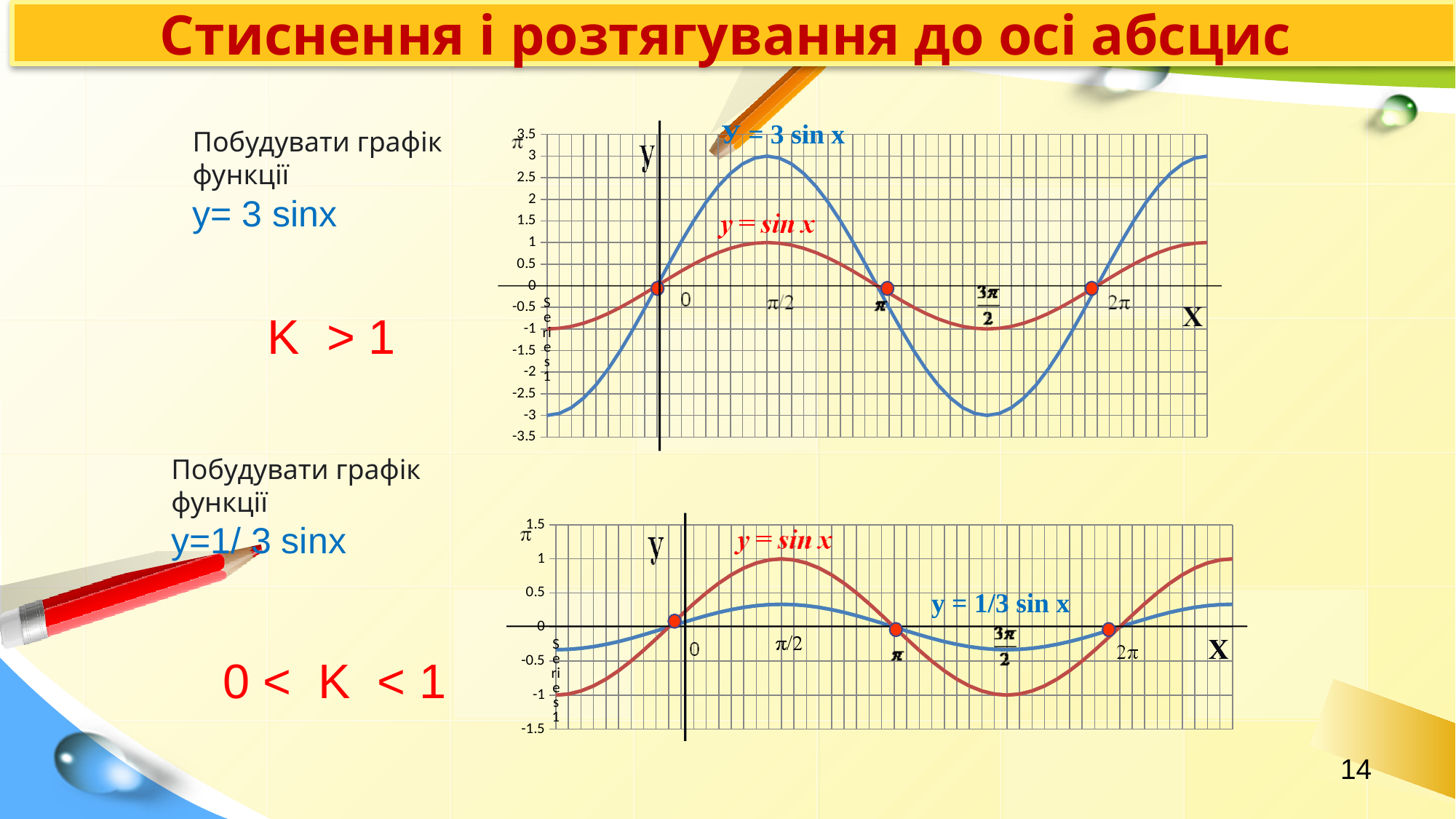
On the top chart, what is the maximum value reached by the curve y = 3 sin x? 3 On the bottom chart, what is the maximum value reached by the curve y = sin x? 1 On the bottom chart, is the peak value of y = 1/3 sin x greater or less than 0.5? less On the top chart, what is the difference between the peak of y = 3 sin x and the peak of y = sin x? 2 On the top chart, what is the minimum value reached by the curve y = 3 sin x? -3 On the bottom chart, what is the highest value labelled on the vertical axis? 1.5 On the bottom chart, what colour is the curve y = 1/3 sin x? blue What type of chart is the top chart on the slide? line chart On the top chart, does the curve y = 3 sin x rise or fall between x = π/2 and x = 3π/2? fall On the top chart, which curve is higher at x = π/2, y = 3 sin x or y = sin x? y = 3 sin x On the top chart, what is the maximum value reached by the curve y = sin x? 1 How many curves are plotted on the top chart? 2